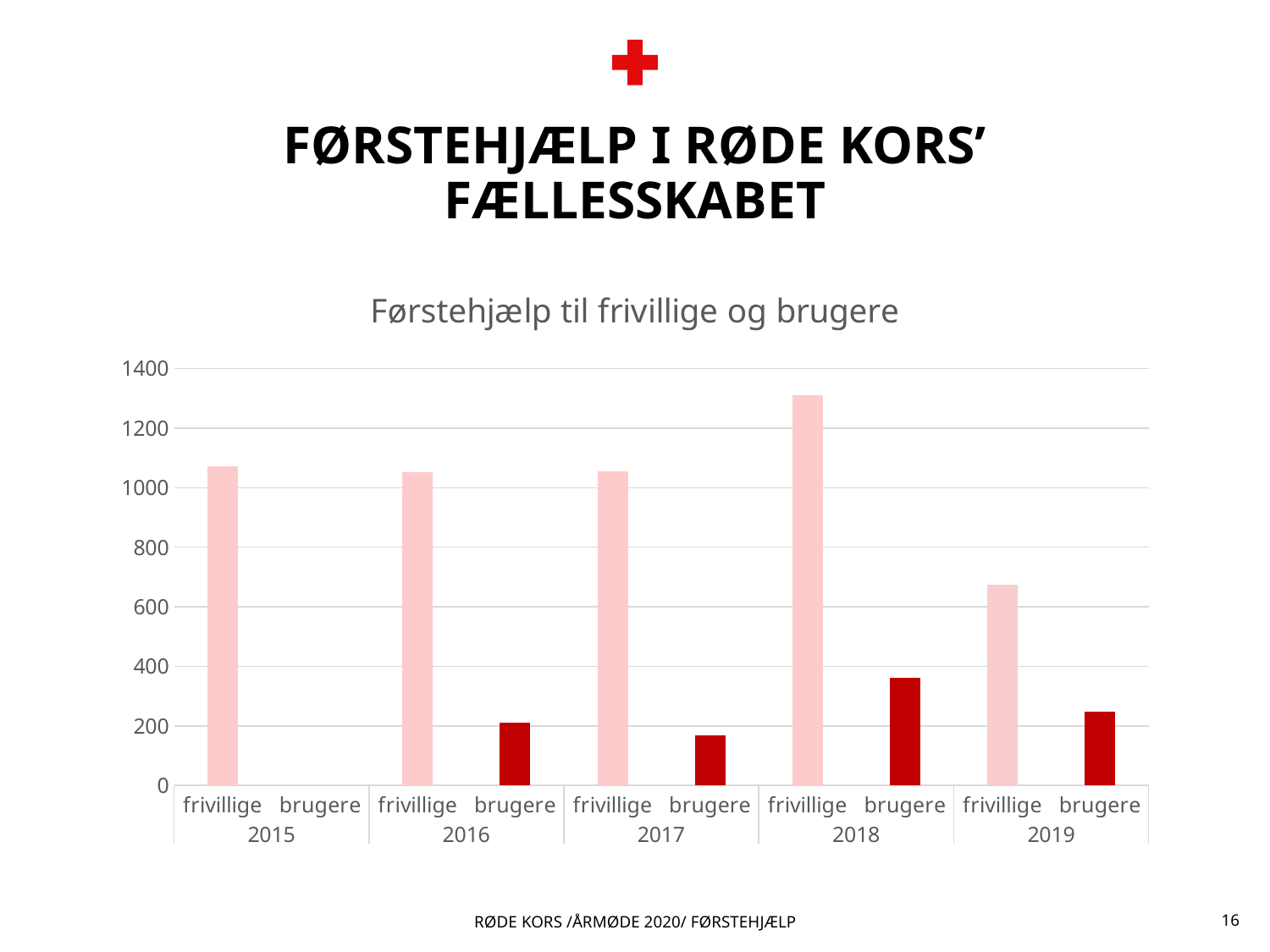
Which is larger, brugere in 2018 or brugere in 2019? brugere in 2018 Which bar is the highest in the chart? frivillige 2018 Is the value for frivillige in 2019 greater or less than 800? less Is the value for brugere in 2017 greater or less than 200? less What kind of chart is shown on the slide? bar chart Which year has the lowest frivillige value? 2019 Is the value for brugere in 2018 greater or less than 400? less Which is larger, frivillige in 2018 or frivillige in 2019? frivillige in 2018 How many years are shown along the x axis of the chart? 5 What is the title of the chart? Førstehjælp til frivillige og brugere